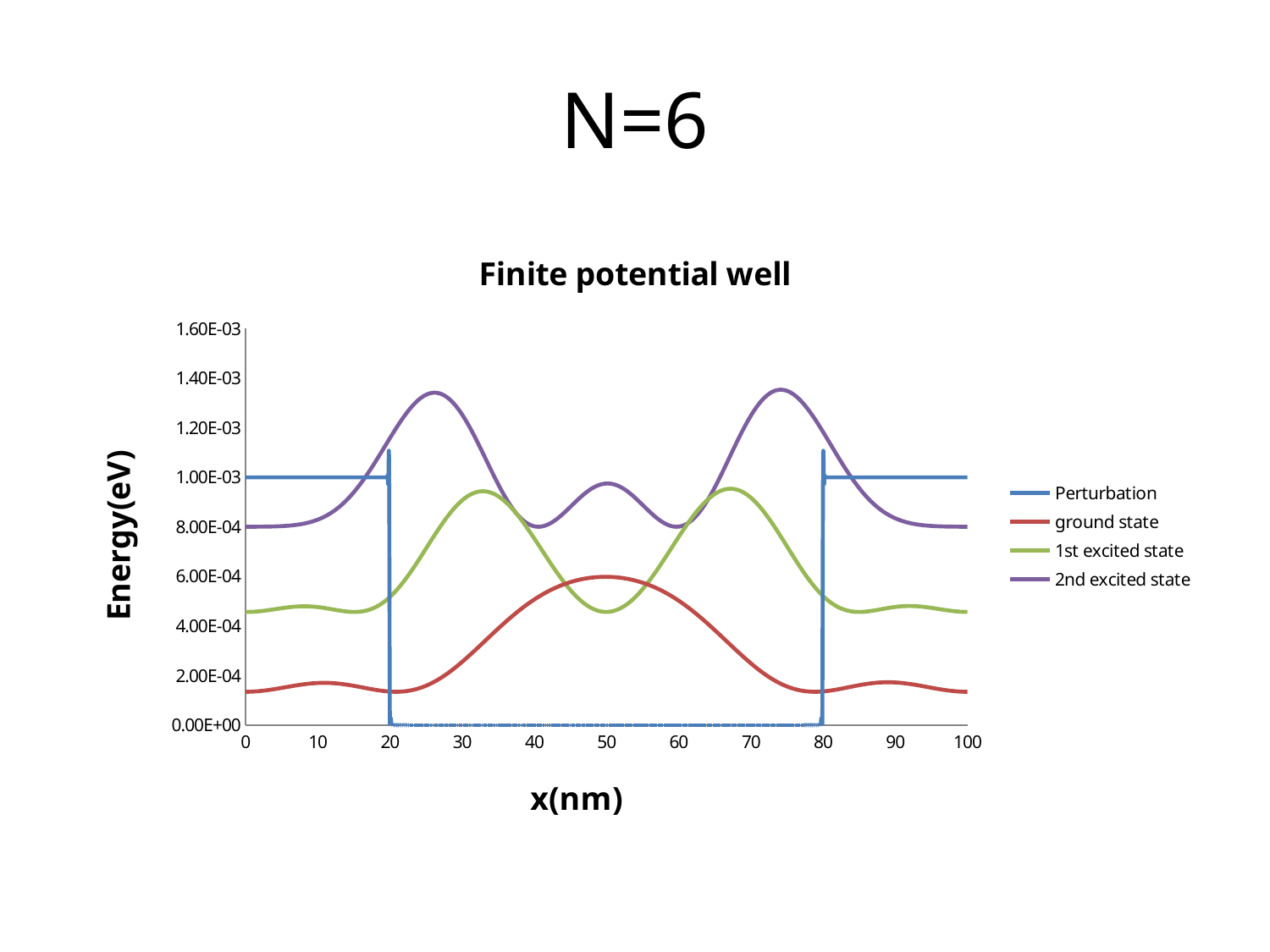
Is the value of the ground state at x = 50 nm greater or less than 8.00E-04? less Is the value of the 2nd excited state at x = 50 nm greater or less than 8.00E-04? greater What is the value of the Perturbation series at x = 50 nm? 0.00E+00 What kind of chart is shown on the slide? line chart What is the value of the Perturbation series at x = 0 nm? 1.00E-03 Is the value of the 1st excited state at x = 0 nm greater or less than 6.00E-04? less Does the ground state rise or fall as x goes from 20 nm to 50 nm? rise What is the label of the vertical axis? Energy(eV) What is the title of the chart? Finite potential well Which series reaches the highest value anywhere on the chart? 2nd excited state How many series does the legend list? 4 At x = 50 nm, which is higher: the ground state or the 1st excited state? ground state